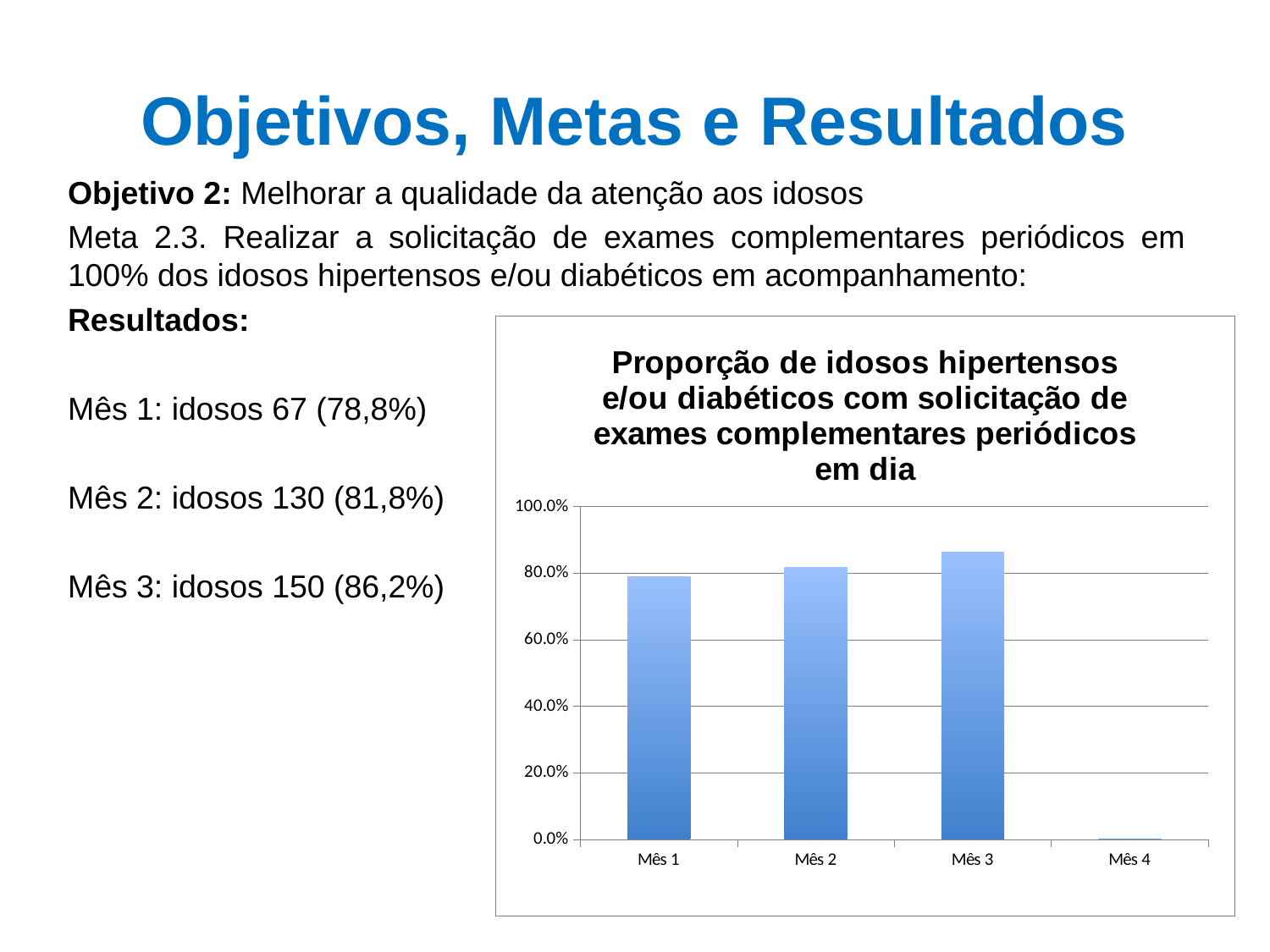
Which month has the highest bar in the chart? Mês 3 What is the title of the chart? Proporção de idosos hipertensos e/ou diabéticos com solicitação de exames complementares periódicos em dia According to the slide, what proportion is shown for Mês 3? 86,2% Which is larger, the value for Mês 1 or the value for Mês 3? Mês 3 How many categories are shown on the x axis of the chart? 4 What type of chart is shown on the slide? bar chart According to the slide, what proportion is shown for Mês 1? 78,8% Is the value for Mês 2 greater or less than 60.0%? greater Do the values rise or fall from Mês 1 to Mês 3? rise Is the value for Mês 1 greater or less than 80.0%? less Which month has the lowest bar in the chart? Mês 4 Is the value for Mês 3 greater or less than 80.0%? greater